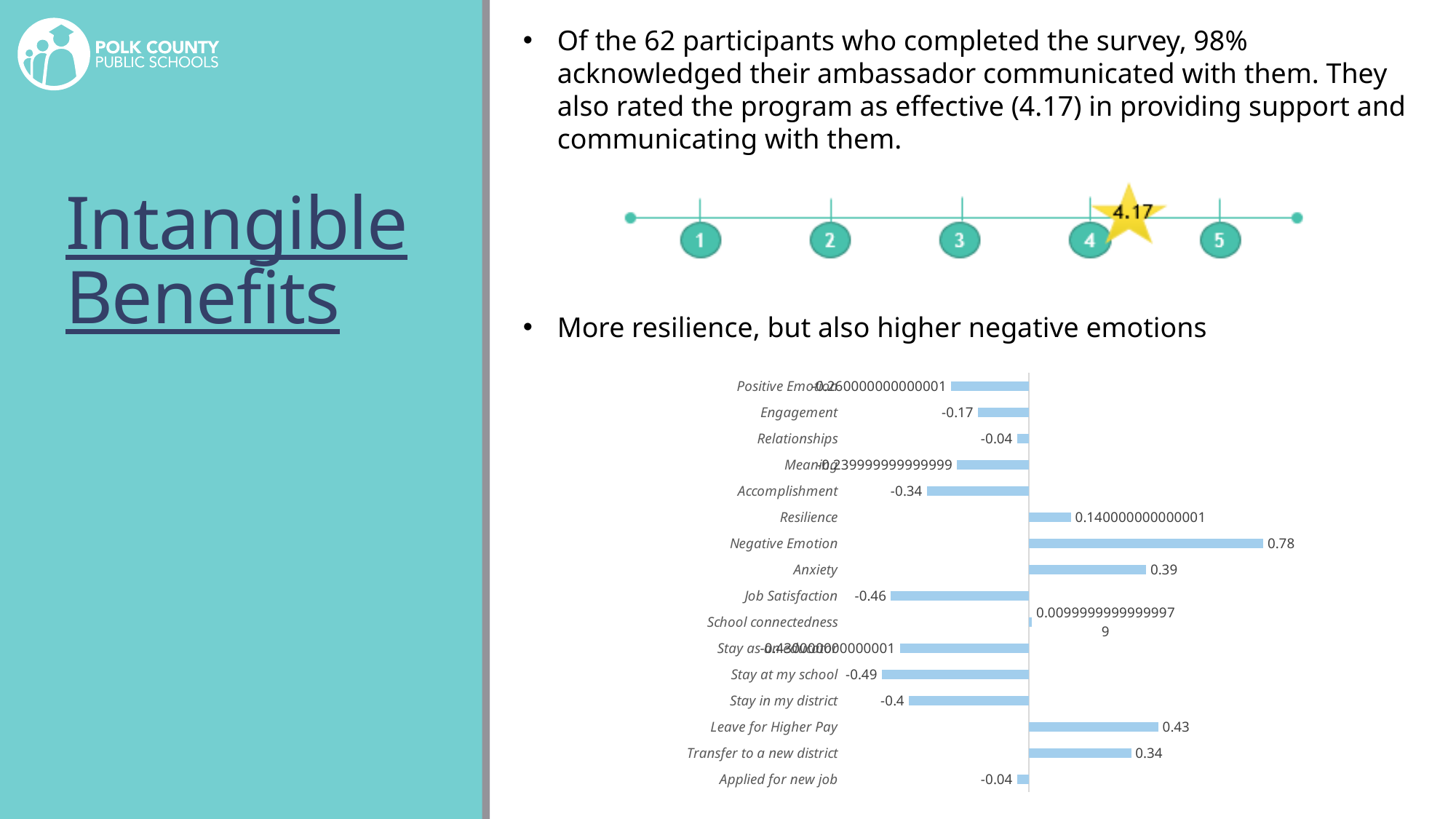
What kind of chart is shown at the bottom of the slide? Bar chart Which category has the highest value in the bar chart? Negative Emotion What is the value for Stay at my school in the bar chart? -0.49 Which is larger in the bar chart, the value for Leave for Higher Pay or the value for Transfer to a new district? Leave for Higher Pay How many categories are shown in the bar chart? 16 What is the value for Anxiety in the bar chart? 0.39 What is the value for Negative Emotion in the bar chart? 0.78 What is the difference between the values for Negative Emotion and Anxiety in the bar chart? 0.39 What is the value for Leave for Higher Pay in the bar chart? 0.43 Which category has the lowest value in the bar chart? Stay at my school What is the value for Accomplishment in the bar chart? -0.34 What is the value for Job Satisfaction in the bar chart? -0.46